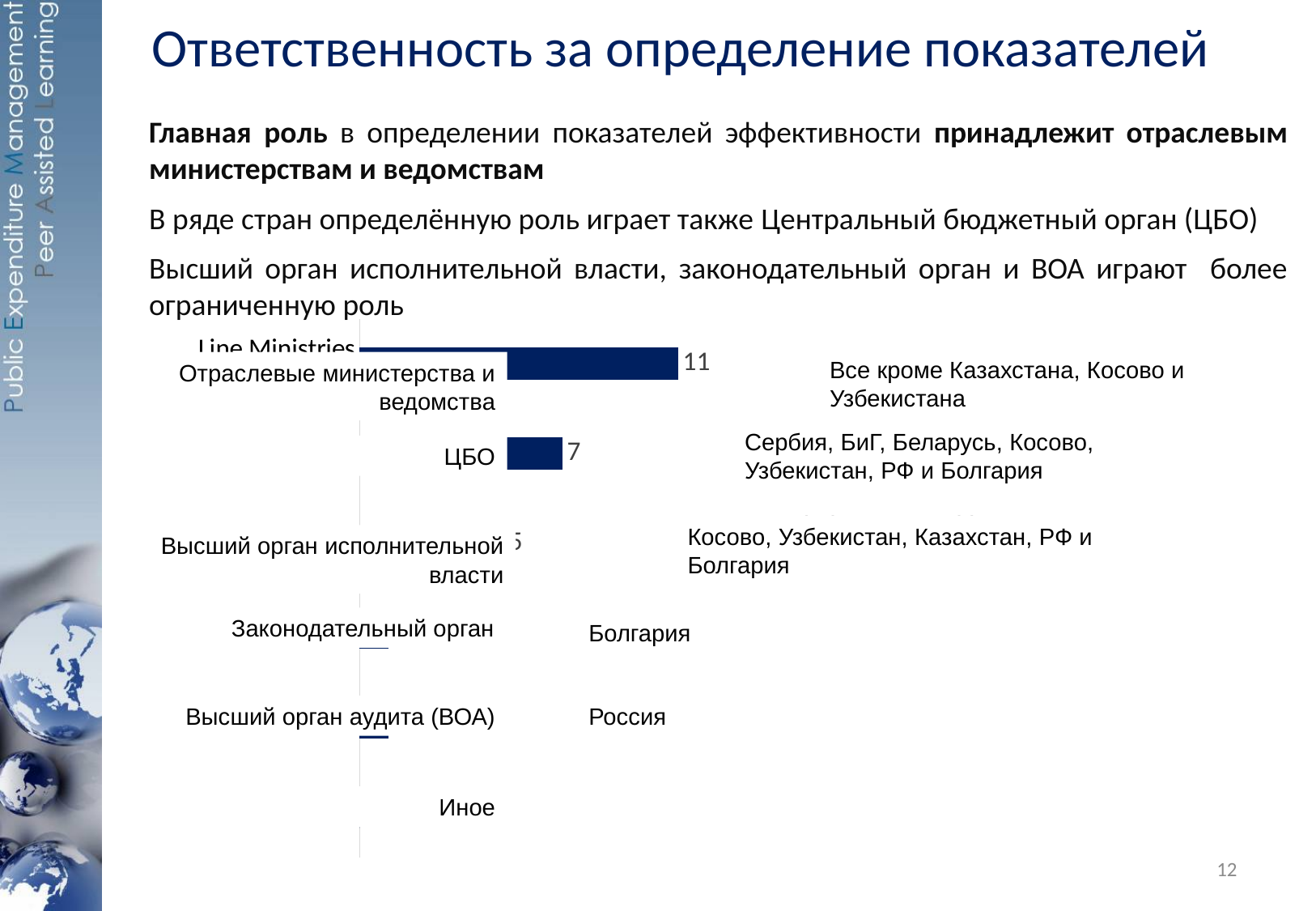
What is the value for Отраслевые министерства и ведомства? 11 How many categories are shown in the chart? 6 What is the value for ЦБО? 7 What is the difference between the values for Отраслевые министерства и ведомства and ЦБО? 4 Which is larger, the value for Отраслевые министерства и ведомства or the value for ЦБО? Отраслевые министерства и ведомства Which country is listed next to the Законодательный орган bar? Болгария Which category has the highest value? Отраслевые министерства и ведомства Which countries are listed next to the ЦБО bar? Сербия, БиГ, Беларусь, Косово, Узбекистан, РФ и Болгария What kind of chart is shown on the slide? bar chart Do the bar values increase or decrease going from the top category to the bottom category? decrease